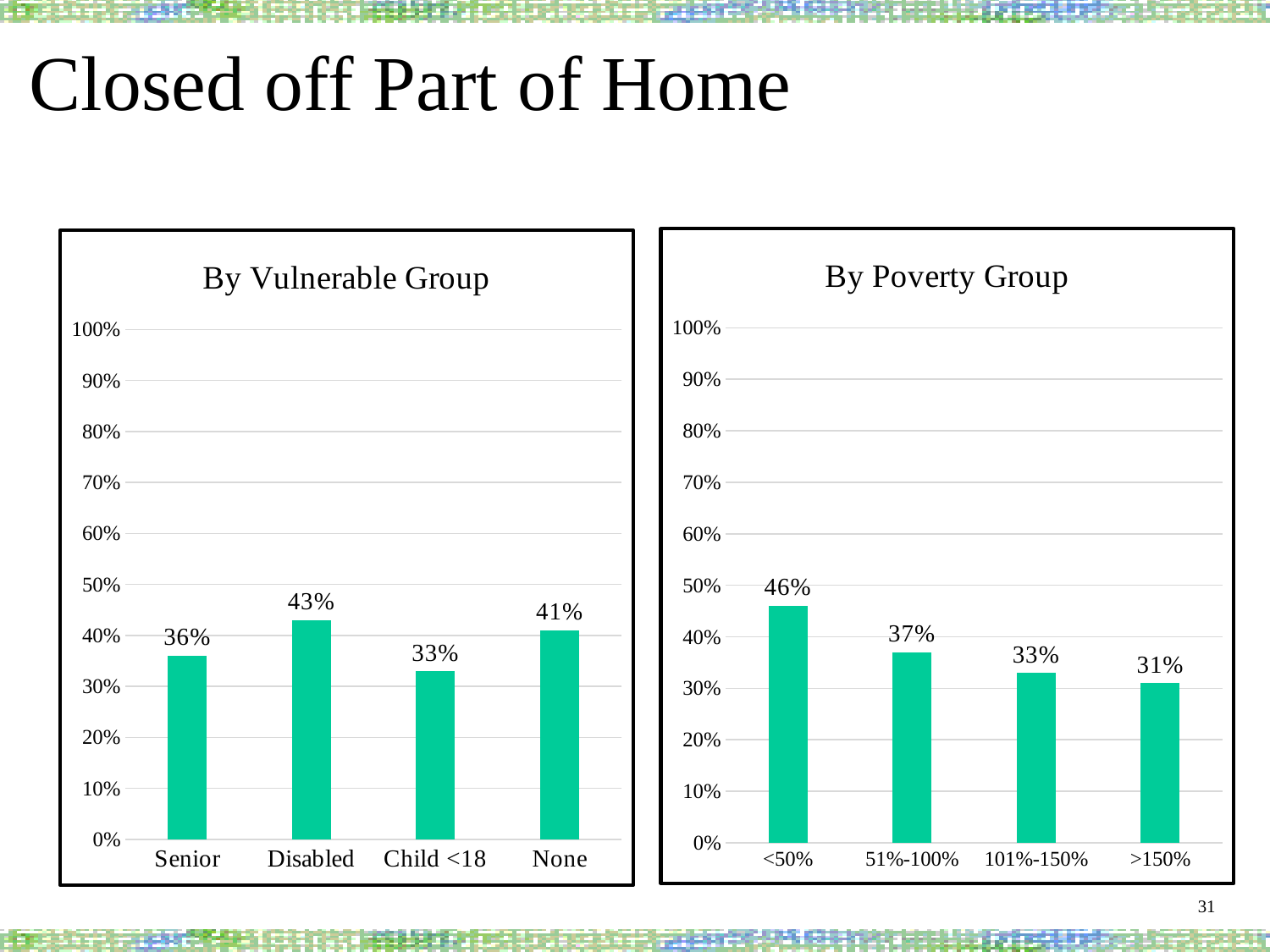
In the 'By Vulnerable Group' chart, which category has the lowest value? Child <18 What is the title of the chart on the left side of the slide? By Vulnerable Group In the 'By Vulnerable Group' chart, which category has the highest value? Disabled In the 'By Poverty Group' chart, do the values rise or fall from left to right along the x axis? fall In the 'By Vulnerable Group' chart, which is larger, the value for Senior or the value for None? None In the 'By Poverty Group' chart, which category has the highest value? <50% In the 'By Vulnerable Group' chart, what is the value for Disabled? 43% How many categories are shown in the 'By Vulnerable Group' chart? 4 In the 'By Poverty Group' chart, which category has the lowest value? >150% In the 'By Poverty Group' chart, what is the value for 51%-100%? 37% In the 'By Poverty Group' chart, what is the difference between the values for <50% and >150%? 15% What kind of chart is the 'By Poverty Group' chart? bar chart